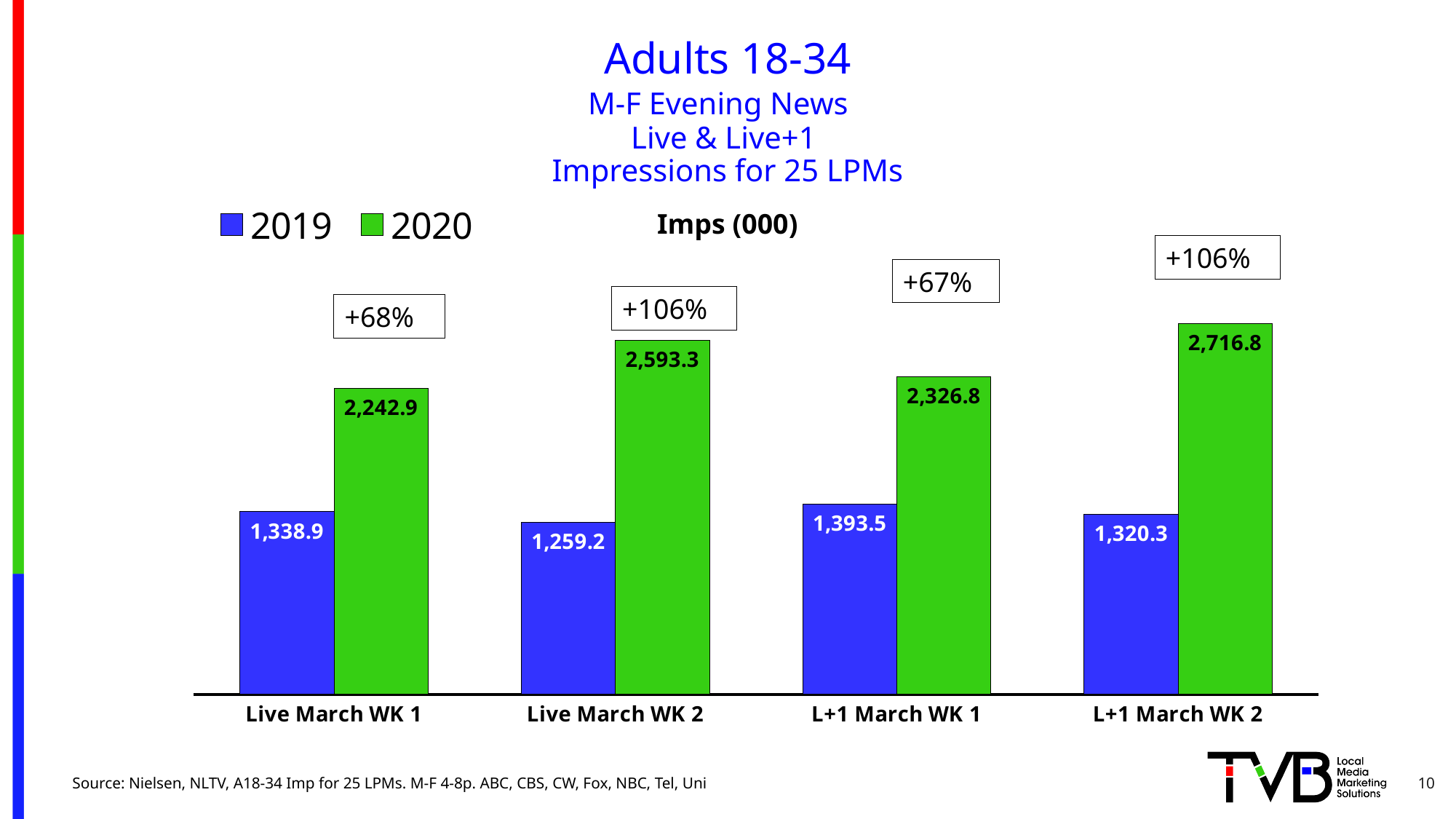
Which category has the lowest 2019 value? Live March WK 2 What is the 2019 value for Live March WK 1? 1,338.9 What kind of chart is shown on the slide? Bar chart How many categories are shown on the x axis? 4 What is the 2020 value for Live March WK 2? 2,593.3 How many series does the legend list? 2 Which category has the highest 2020 value? L+1 March WK 2 What is the 2019 value for L+1 March WK 1? 1,393.5 Which colour represents the 2020 series? Green What percentage change is shown above the L+1 March WK 1 bars? +67% What is the difference between the 2020 and 2019 values for L+1 March WK 2? 1,396.5 Which is larger, the 2019 value for Live March WK 1 or the 2019 value for Live March WK 2? Live March WK 1